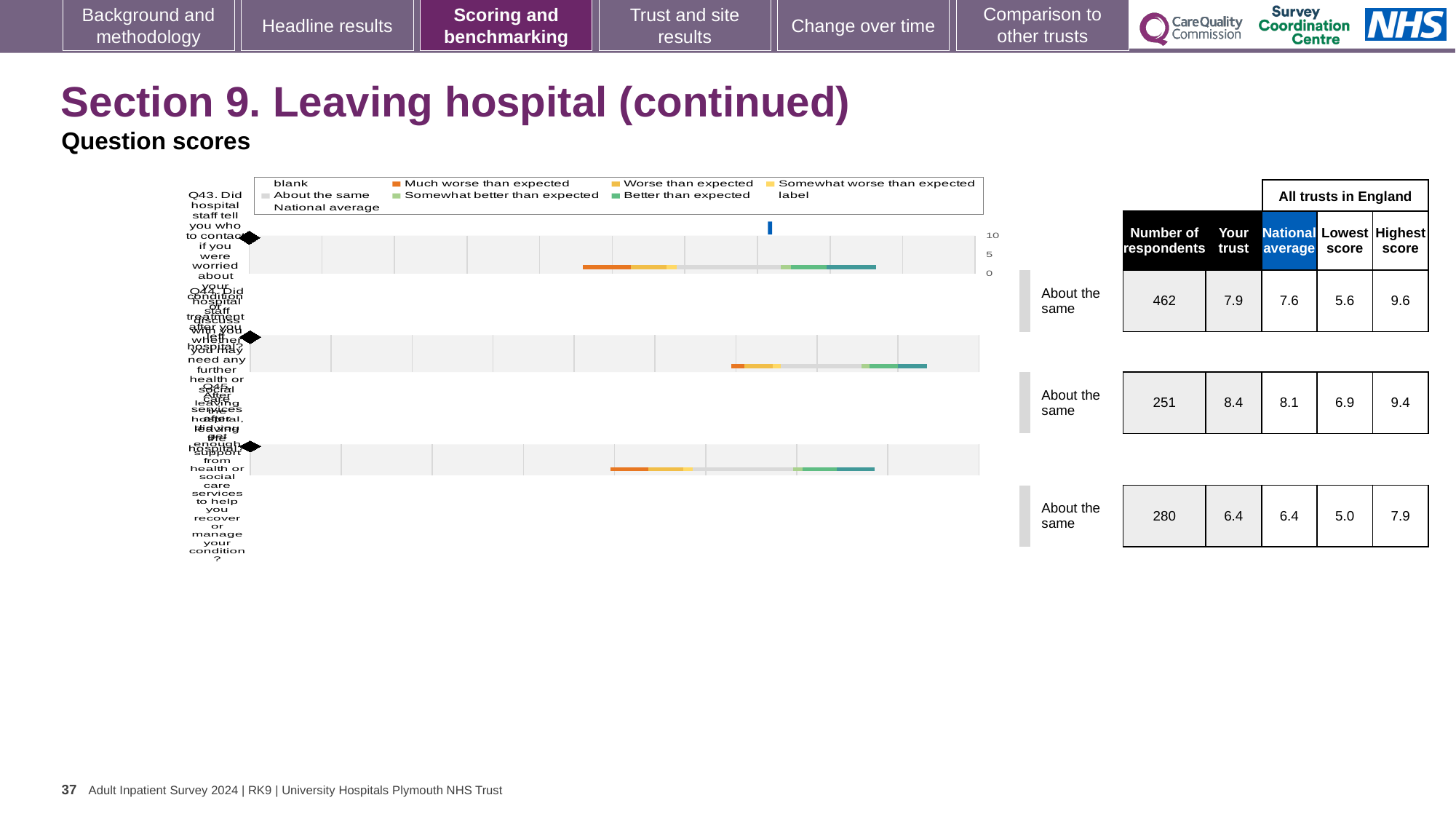
For the middle chart (Q44), what is the difference between the highest score and the lowest score? 2.5 For the top chart (Q43), what is the 'Your trust' score shown in the table? 7.9 For the top chart (Q43), what is the difference between the 'Your trust' score and the national average? 0.3 Which of the three charts has the lowest 'Your trust' score? the bottom chart (Q45), 6.4 Which has more respondents, the top chart (Q43) or the bottom chart (Q45)? the top chart (Q43) Which of the three charts has the highest 'Your trust' score? the middle chart (Q44), 8.4 For the top chart (Q43), what is the number of respondents? 462 How many question score charts are shown on the slide? 3 In the chart legend, which colour represents 'Much worse than expected'? orange What kind of chart is used to show the question scores on this slide? bar chart For the middle chart (Q44), what is the national average score? 8.1 For the bottom chart (Q45), what is the highest score among all trusts in England? 7.9